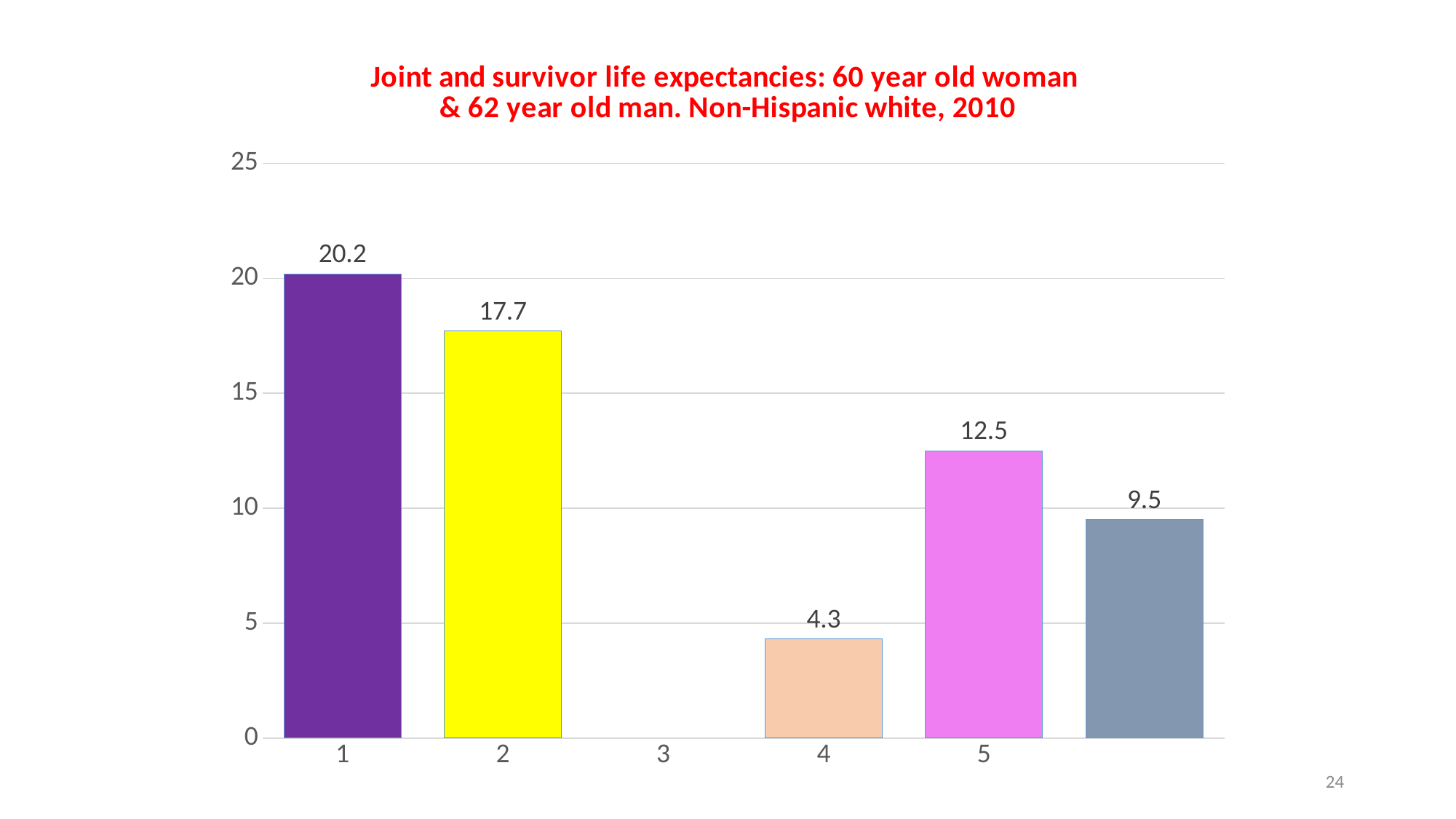
What is the value for category 4? 4.3 What is the value for category 2? 17.7 Which labelled category has the highest value? 1 Which is larger, the value for category 2 or the value for category 5? category 2 Which labelled category with a bar has the lowest value? 4 What is the difference between the values for category 1 and category 2? 2.5 What is the title of the chart? Joint and survivor life expectancies: 60 year old woman & 62 year old man. Non-Hispanic white, 2010 What kind of chart is shown on the slide? bar chart What is the difference between the values for category 5 and category 4? 8.2 What is the value for category 5? 12.5 Is the value for category 5 greater or less than 10? greater What is the value for category 1? 20.2